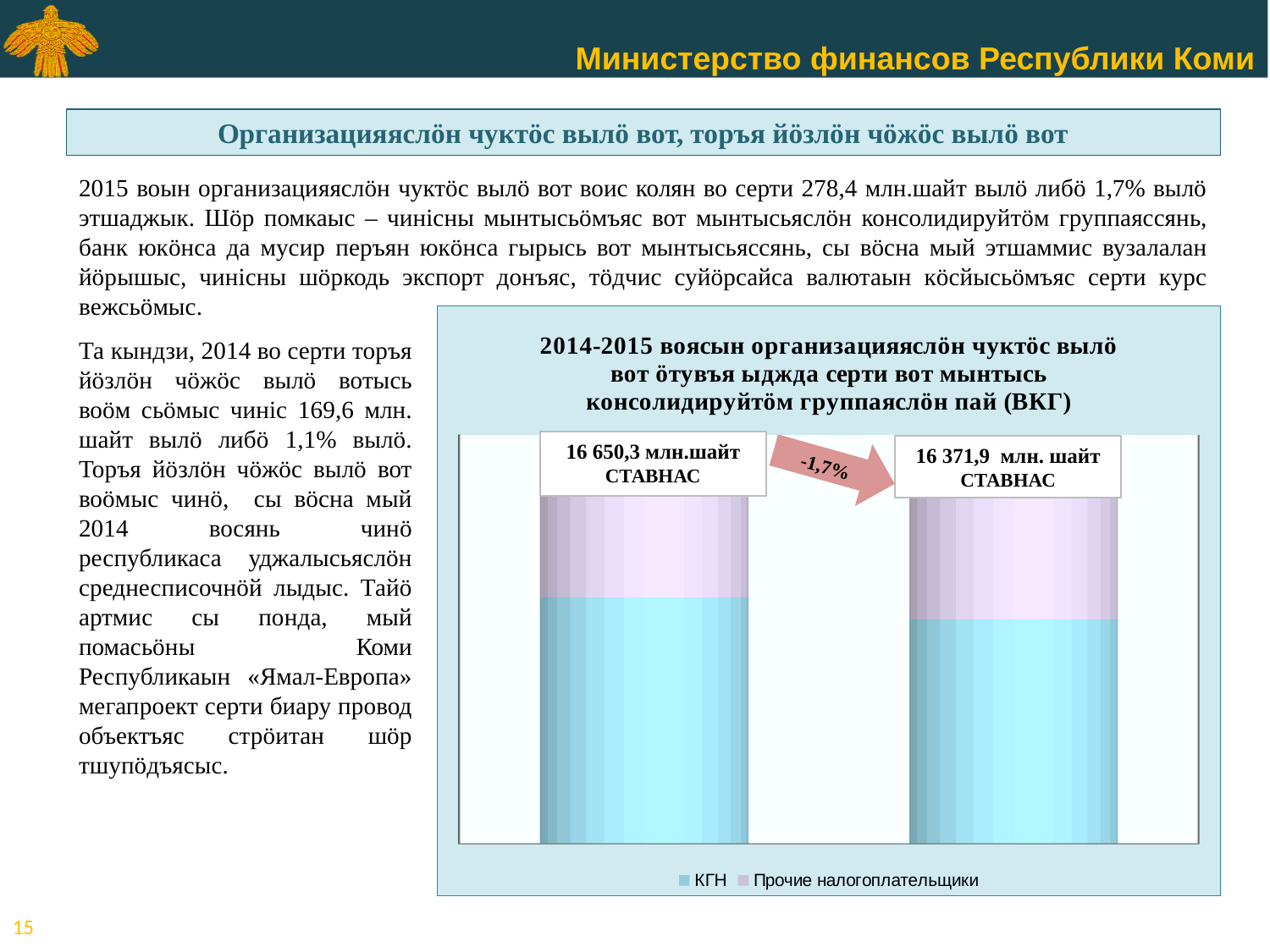
Do the bar totals rise or fall from the left bar to the right bar? fall What percentage change is printed on the arrow between the two bars? -1,7% What are the two entries listed in the chart legend? КГН and Прочие налогоплательщики Which bar has the larger total, the left bar or the right bar? the left bar What is the difference between the total of the left bar (16 650,3) and the total of the right bar (16 371,9)? 278,4 In the right bar, which segment is larger, КГН or Прочие налогоплательщики? КГН In the left bar, which segment is larger, КГН or Прочие налогоплательщики? КГН How many stacked bars are plotted in the chart? 2 What kind of chart is shown on the slide? bar chart How many series does the chart legend list? 2 What total value is printed above the left bar of the chart? 16 650,3 млн.шайт What total value is printed above the right bar of the chart? 16 371,9 млн. шайт